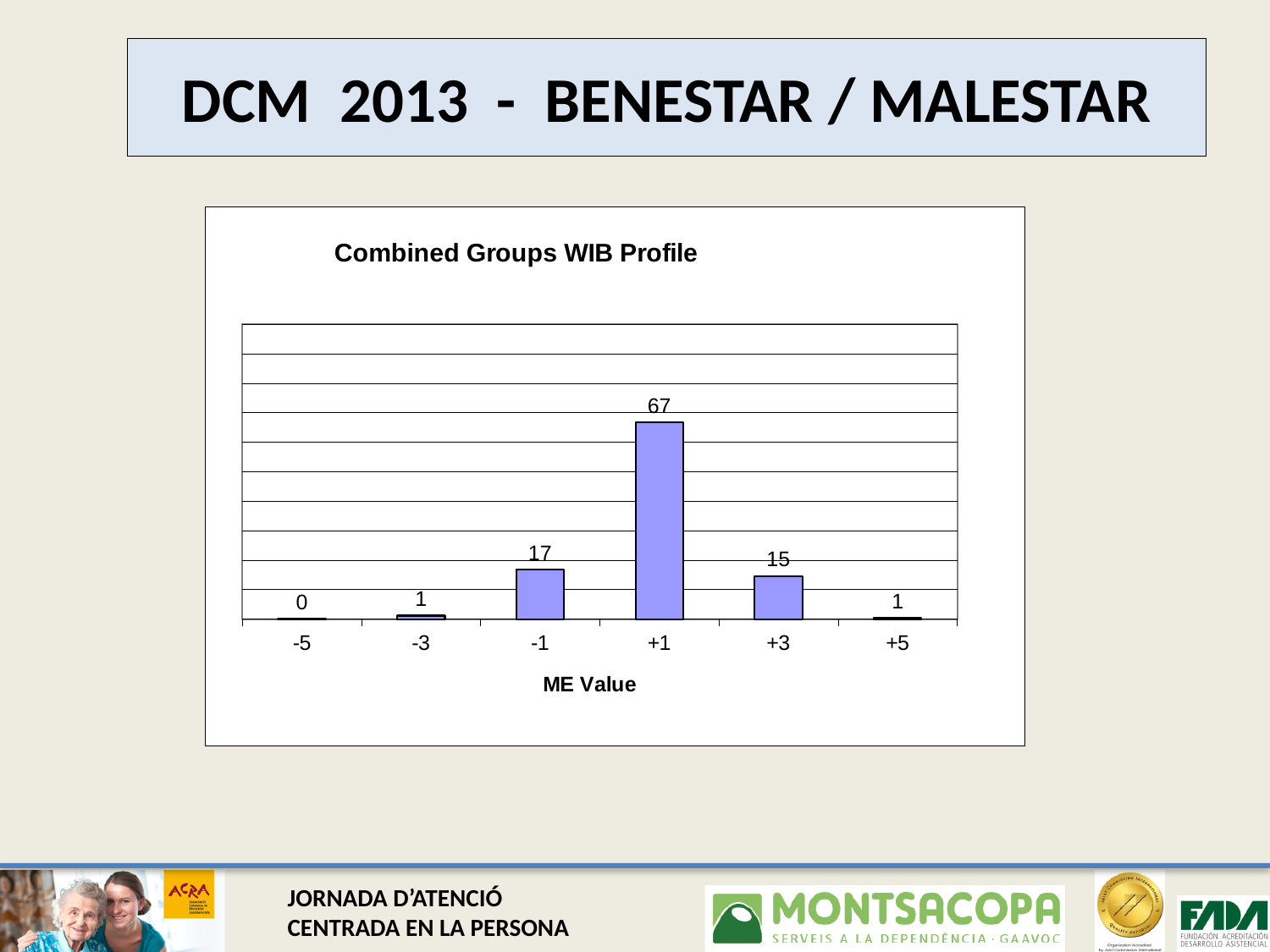
Which is larger, the value for -3 or the value for +3? +3 What is the value for ME Value -5? 0 How many ME Value categories are shown on the x axis? 6 What is the title of the chart? Combined Groups WIB Profile What is the difference between the values for +1 and -1? 50 What is the difference between the values for -1 and +3? 2 What is the value for ME Value +3? 15 What is the value for ME Value +1? 67 Which ME Value category has the highest value? +1 What is the value for ME Value -1? 17 Which ME Value category has the lowest value? -5 What kind of chart is shown? bar chart